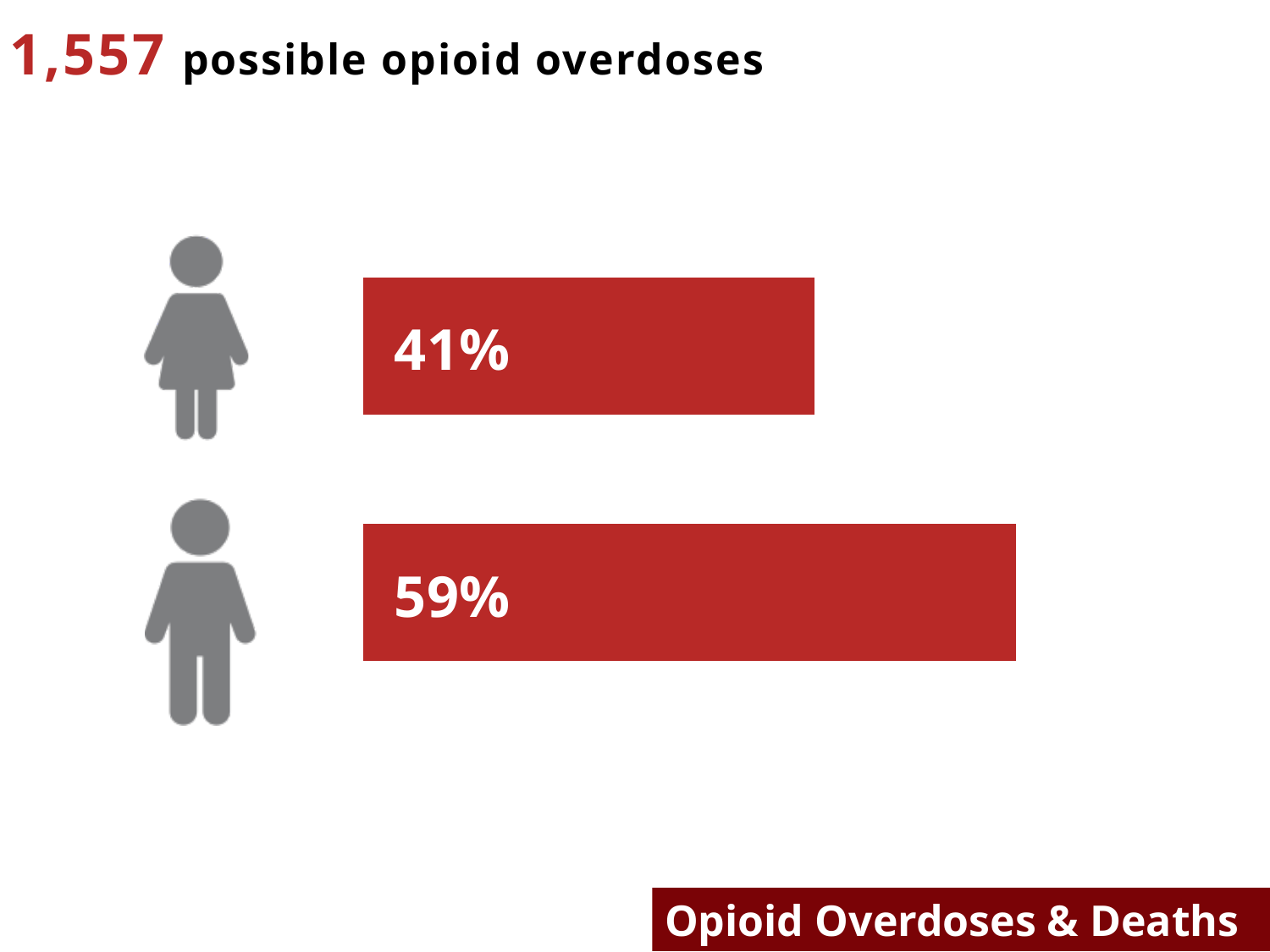
What percentage is shown for the bar next to the female icon? 41% Which category has the highest percentage? male What is the total of the two percentages shown? 100% Which category has the lowest percentage? female What is the difference between the male and female percentages? 18% What number of possible opioid overdoses is stated at the top of the slide? 1,557 What percentage is shown for the bar next to the male icon? 59% What kind of chart is shown on the slide? bar chart Which bar is longer, the one next to the female icon or the one next to the male icon? male How many bars are shown in the chart? 2 What colour are the bars in the chart? red